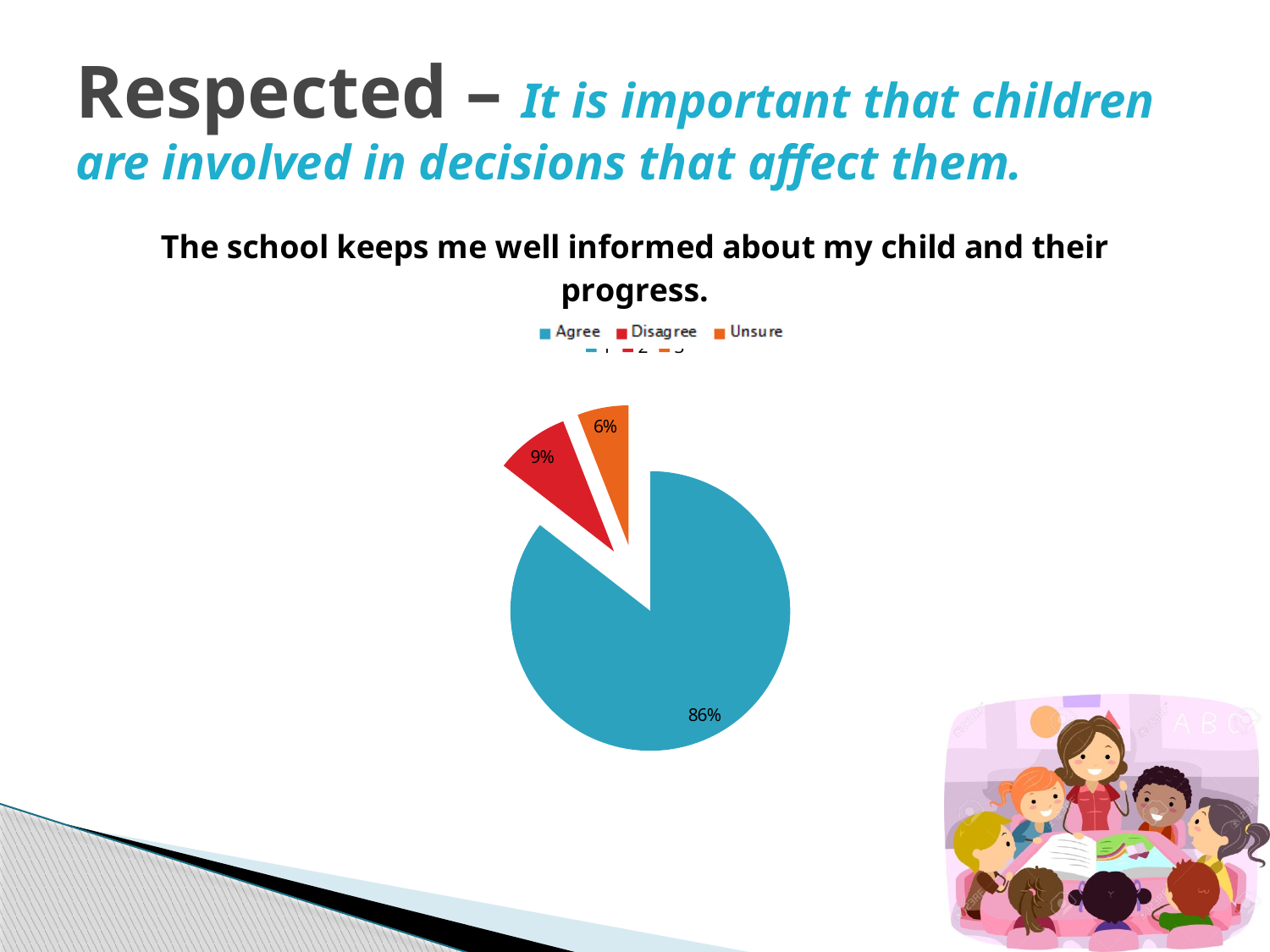
How many entries does the legend list? 3 What is the difference in percentage points between Agree and Disagree? 77 What type of chart is shown on the slide? pie chart What percentage of respondents chose Unsure? 6% What percentage of respondents chose Disagree? 9% What colour is the Agree slice? blue What percentage of respondents chose Agree? 86% Which response has the smallest share of the pie? Unsure What is the difference in percentage points between Disagree and Unsure? 3 Which is larger, the Disagree slice or the Unsure slice? Disagree Which response has the largest share of the pie? Agree How many slices does the pie chart have? 3